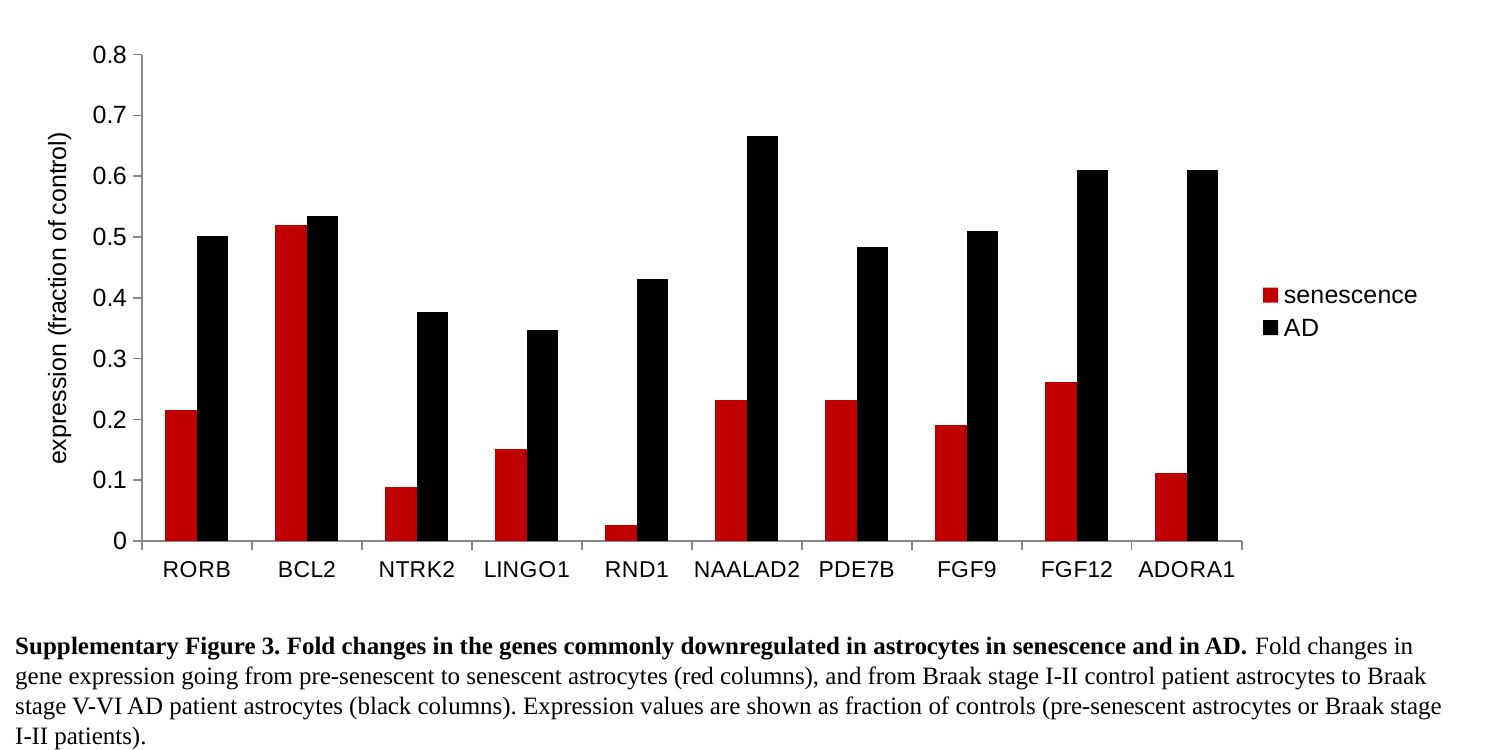
How many series does the chart's legend list? 2 Is the AD value for NTRK2 greater or less than 0.3? greater Is the senescence value for BCL2 greater or less than 0.4? greater For RORB, which is larger: the senescence value or the AD value? AD Is the AD value for NAALAD2 greater or less than 0.6? greater Which gene has the lowest senescence value? RND1 What is the label on the y axis of the chart? expression (fraction of control) How many genes are shown along the x axis of the chart? 10 What kind of chart is shown on the slide? bar chart Which gene has the highest AD value? NAALAD2 Which gene has the highest senescence value? BCL2